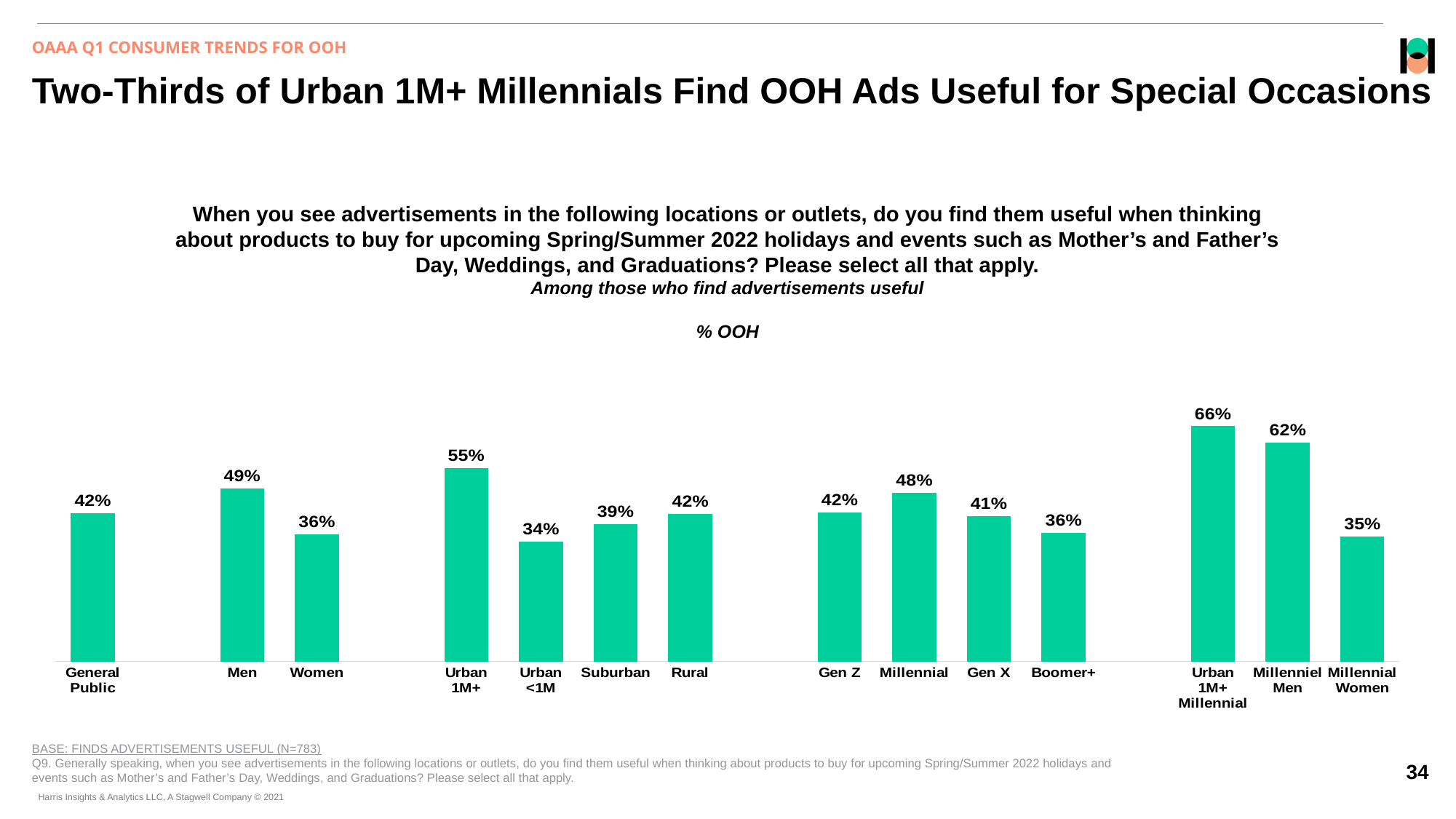
What is the value for Suburban? 39% Which is larger, the value for Millennial or the value for Gen X? Millennial What is the value for Boomer+? 36% What is the difference between the values for Urban 1M+ and Urban <1M? 21% What is the value for Urban 1M+ Millennial? 66% How many bars are shown in the chart? 14 Which category has the highest value? Urban 1M+ Millennial What kind of chart is shown on the slide? Bar chart What is the value for the General Public? 42% What is the difference between the values for Men and Women? 13% What is the label shown above the chart indicating what the values measure? % OOH Which category has the lowest value? Urban <1M